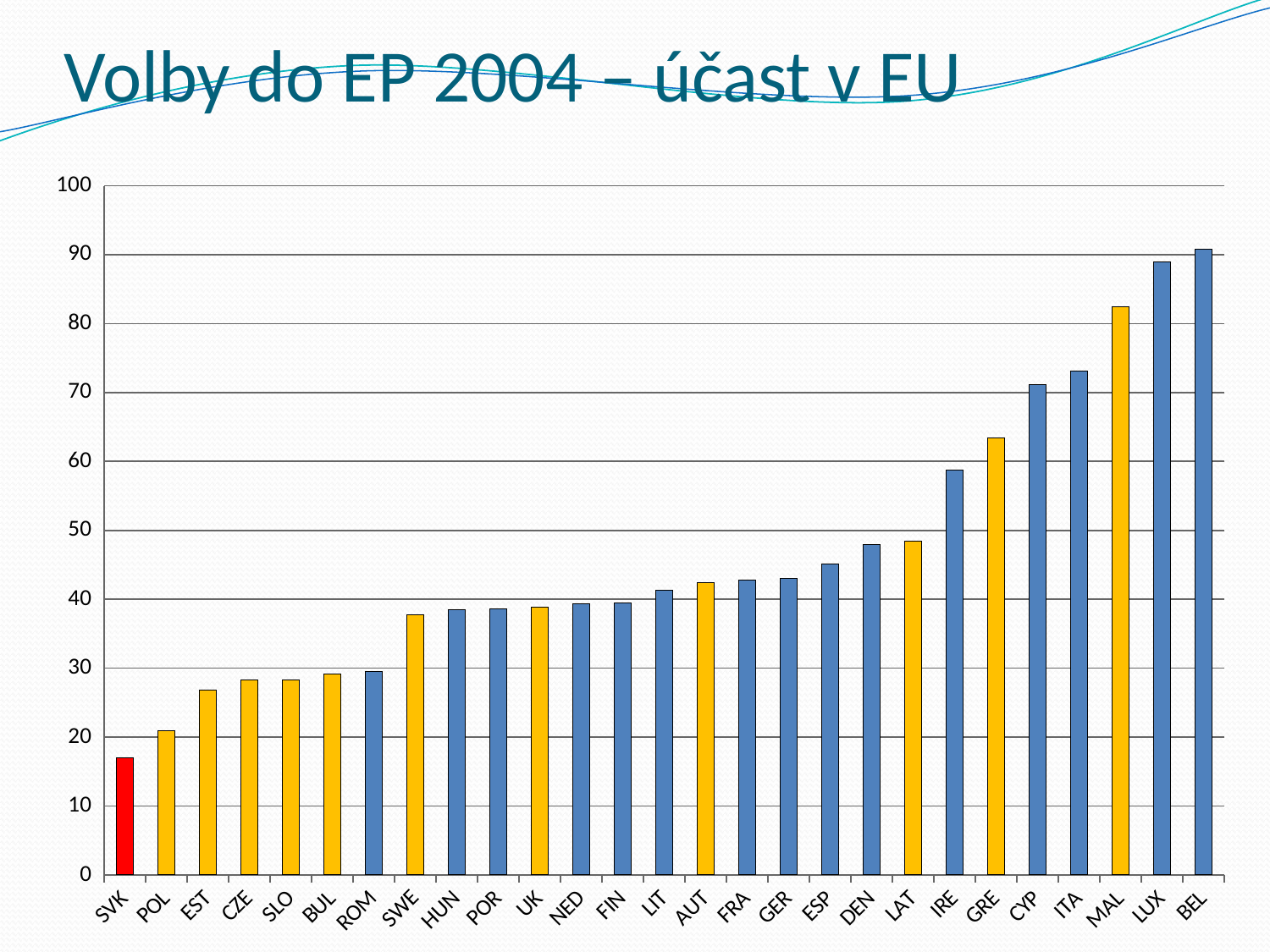
Is the value for GRE greater or less than 60? greater Which country has the highest bar in the chart? BEL What kind of chart is shown on the slide? bar chart Is the value for IRE greater or less than 50? greater What is the title of the slide containing the chart? Volby do EP 2004 – účast v EU Do the bar values rise or fall from left to right along the x axis? rise Which has the larger value, MAL or ITA? MAL How many countries are shown on the x axis of the chart? 27 Which country has the lowest bar in the chart? SVK Is the value for SVK greater or less than 20? less